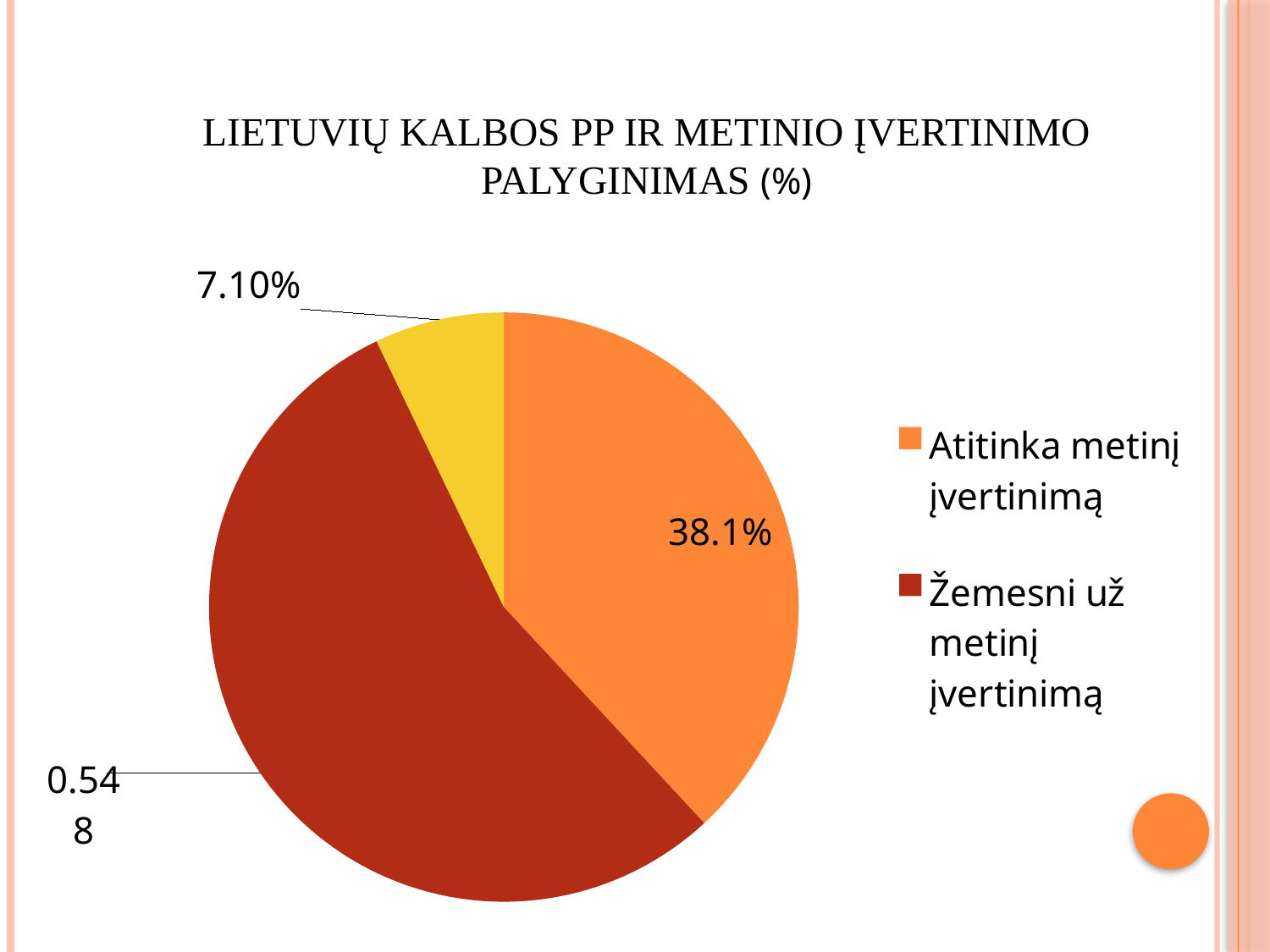
What value is shown for the yellow slice of the pie? 7.10% What is the title of the chart? LIETUVIŲ KALBOS PP IR METINIO ĮVERTINIMO PALYGINIMAS (%) What value is shown for the "Žemesni už metinį įvertinimą" slice? 0.548 What kind of chart is shown on the slide? pie chart How many slices does the pie chart have? 3 Which legend category has the largest slice of the pie? Žemesni už metinį įvertinimą Which slice is larger: "Atitinka metinį įvertinimą" or "Žemesni už metinį įvertinimą"? Žemesni už metinį įvertinimą Which slice of the pie is the smallest? the yellow slice (7.10%) How many entries does the legend list? 2 What colour is the "Atitinka metinį įvertinimą" slice? orange What value is shown for the "Atitinka metinį įvertinimą" slice? 38.1%